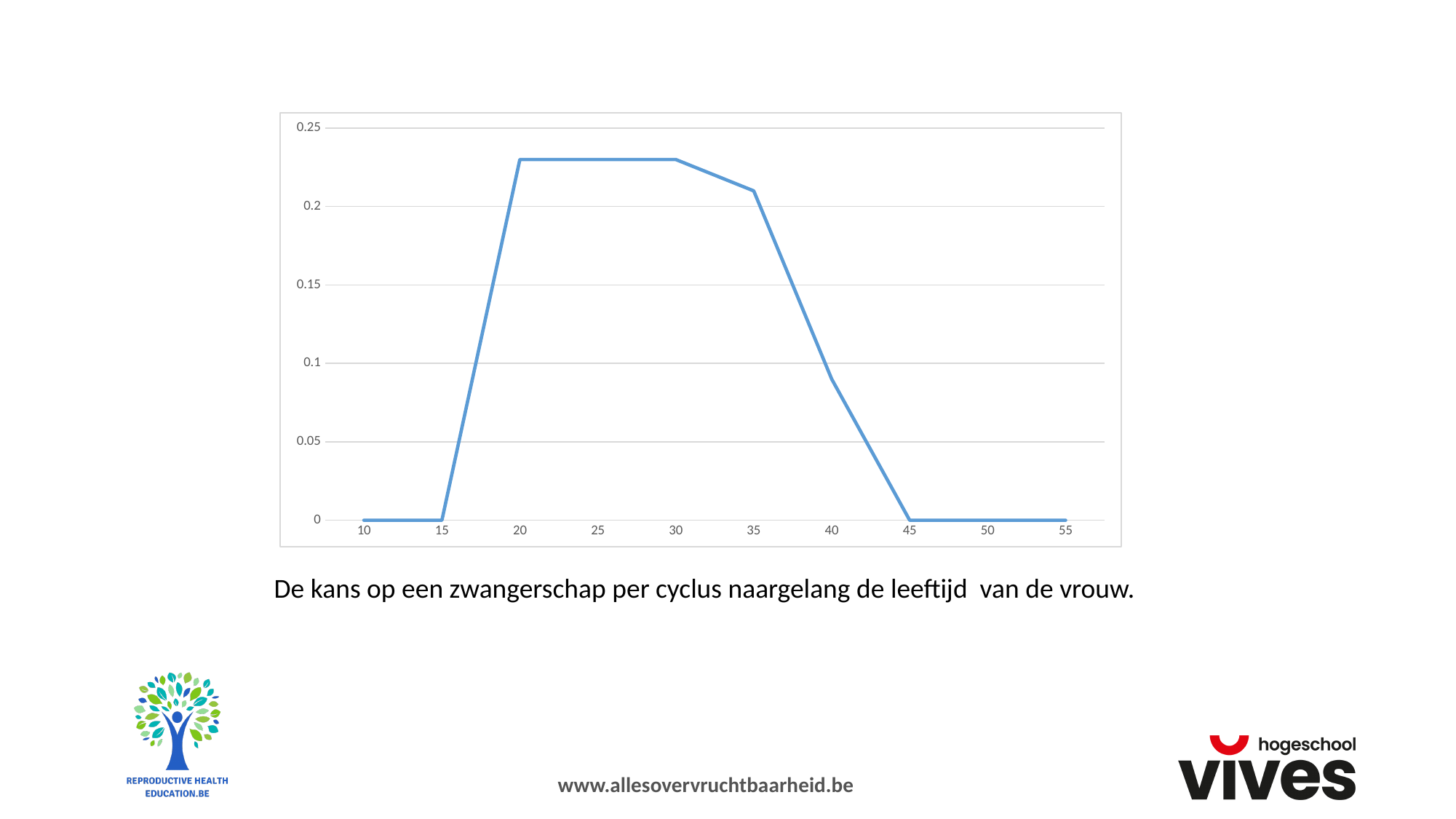
Is the value at x = 35 greater or less than 0.2? greater Which is larger, the value at x = 30 or the value at x = 40? x = 30 What is the value at x = 10? 0 How many data points are plotted along the x axis? 10 What is the value at x = 50? 0 Is the value at x = 40 greater or less than 0.1? less What kind of chart is shown on the slide? line chart Is the value at x = 25 greater or less than 0.2? greater Do the values rise or fall between x = 15 and x = 20? rise What caption is written below the chart? De kans op een zwangerschap per cyclus naargelang de leeftijd van de vrouw. What is the highest value shown on the y axis? 0.25 Do the values rise or fall between x = 35 and x = 45? fall